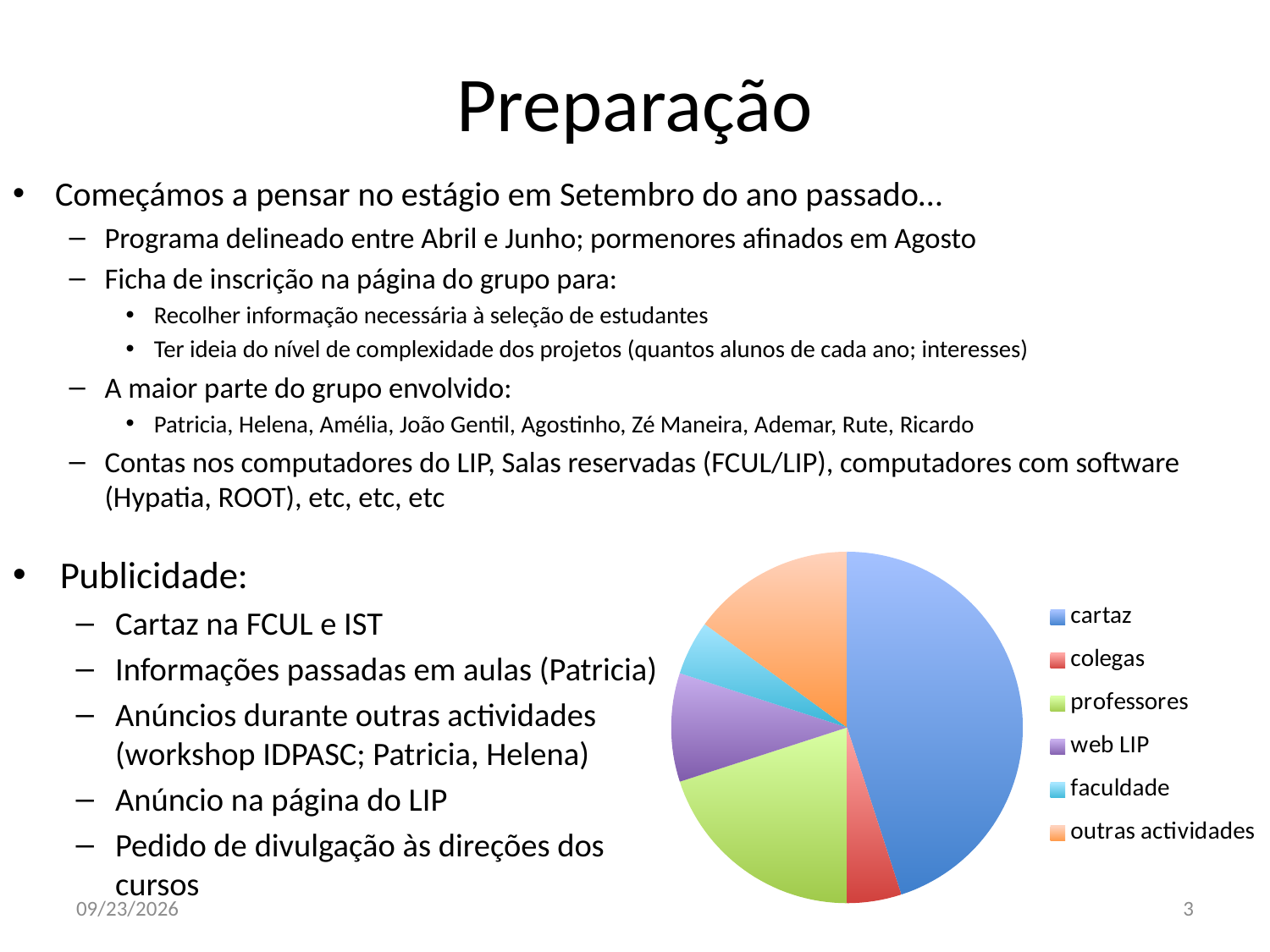
Which category has the largest slice in the pie chart? cartaz Which slice is larger in the pie chart, professores or colegas? professores Which slice is larger in the pie chart, cartaz or professores? cartaz How many entries does the legend of the pie chart list? 6 Which slice is larger in the pie chart, outras actividades or faculdade? outras actividades What colour is the cartaz slice in the pie chart? blue How many slices does the pie chart have? 6 What kind of chart is shown on the slide? pie chart